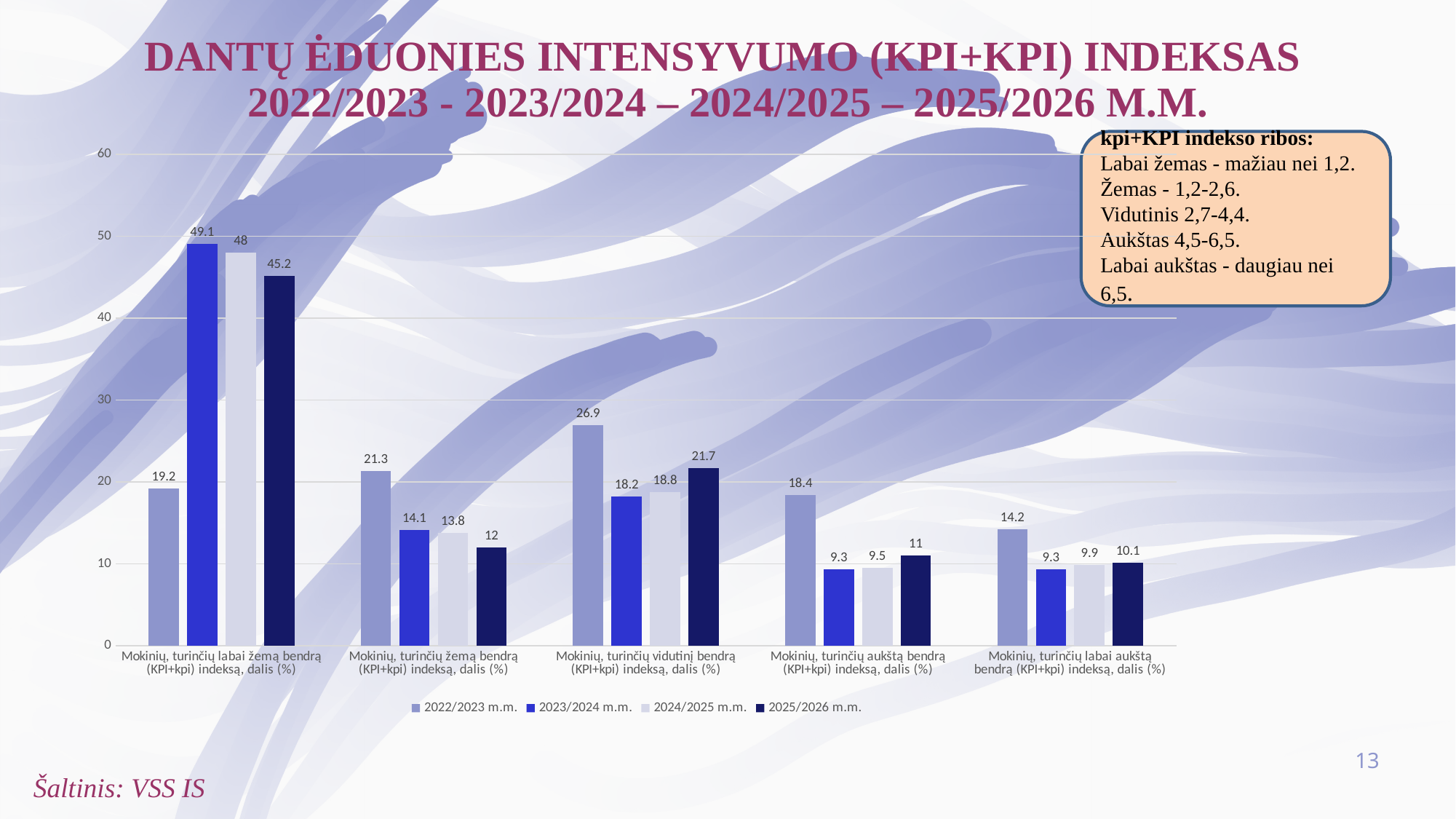
What type of chart is shown on the slide? bar chart What is the difference between the 2022/2023 m.m. and 2025/2026 m.m. values in the category 'Mokinių, turinčių labai aukštą bendrą (KPI+kpi) indeksą, dalis (%)'? 4.1 What is the value for 2023/2024 m.m. in the category 'Mokinių, turinčių labai žemą bendrą (KPI+kpi) indeksą, dalis (%)'? 49.1 Which series is shown in the darkest navy colour in the legend? 2025/2026 m.m. In the category 'Mokinių, turinčių vidutinį bendrą (KPI+kpi) indeksą, dalis (%)', which is larger: the 2022/2023 m.m. value or the 2024/2025 m.m. value? 2022/2023 m.m. How many categories are shown on the x axis? 5 What is the value for 2022/2023 m.m. in the category 'Mokinių, turinčių aukštą bendrą (KPI+kpi) indeksą, dalis (%)'? 18.4 How many series does the legend list? 4 Which series has the highest value in the category 'Mokinių, turinčių labai žemą bendrą (KPI+kpi) indeksą, dalis (%)'? 2023/2024 m.m. What is the value for 2025/2026 m.m. in the category 'Mokinių, turinčių vidutinį bendrą (KPI+kpi) indeksą, dalis (%)'? 21.7 Is the 2024/2025 m.m. value for 'Mokinių, turinčių labai žemą bendrą (KPI+kpi) indeksą, dalis (%)' greater or less than 40? greater Which series has the lowest value in the category 'Mokinių, turinčių žemą bendrą (KPI+kpi) indeksą, dalis (%)'? 2025/2026 m.m.